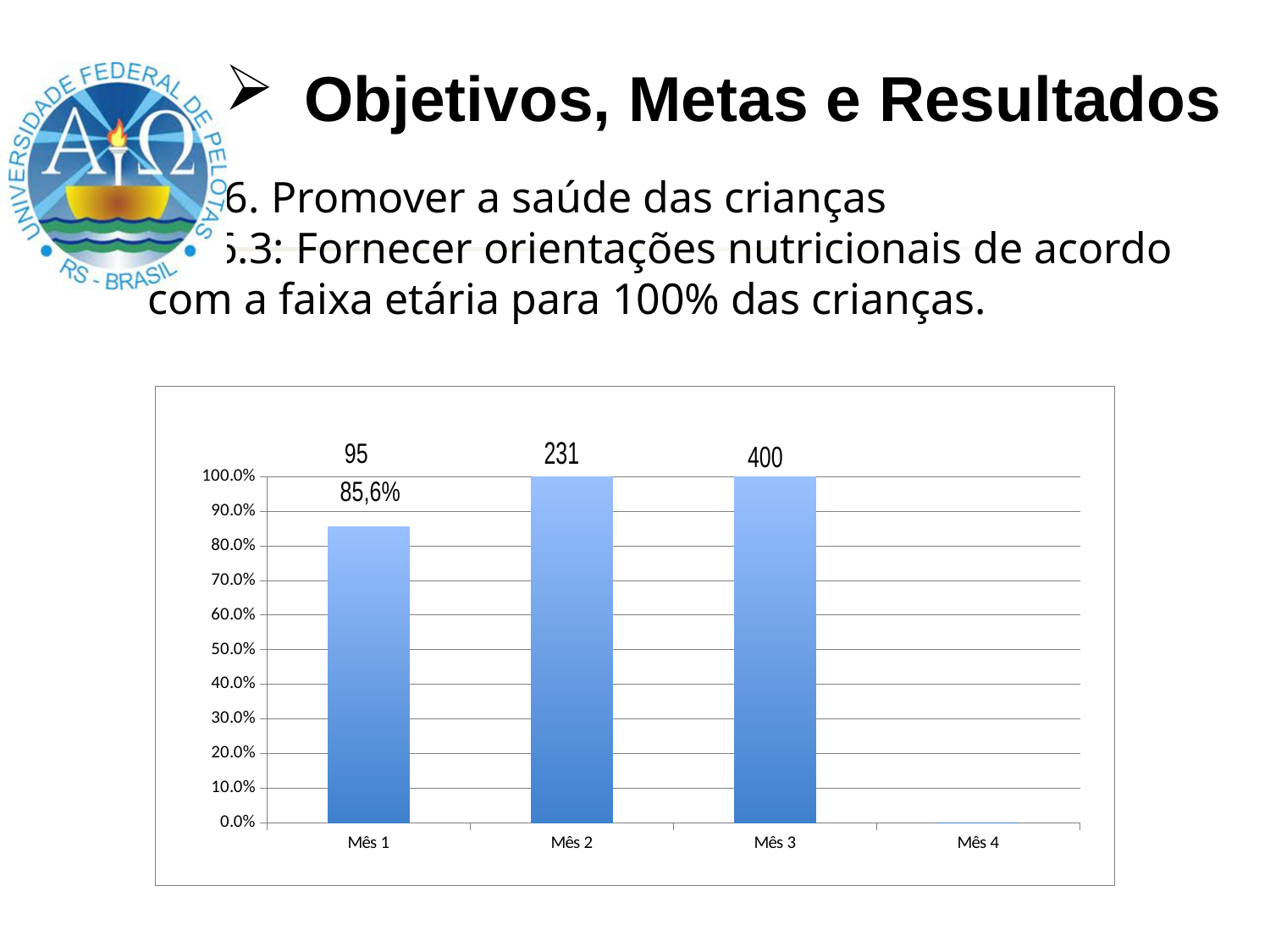
How many categories are shown on the x axis of the chart? 4 What percentage does the bar for Mês 2 reach on the y axis? 100.0% Which is larger, the value for Mês 3 or the value for Mês 4? Mês 3 Which category has the lowest value in the chart? Mês 4 What type of chart is shown on the slide? bar chart Is the value for Mês 1 greater or less than 80.0%? greater What number is printed above the bar for Mês 3? 400 What is the percentage value shown for Mês 1? 85,6% Which is larger, the value for Mês 1 or the value for Mês 2? Mês 2 Is the value for Mês 4 greater or less than 10.0%? less What number is printed above the bar for Mês 2? 231 What percentage does the bar for Mês 3 reach on the y axis? 100.0%